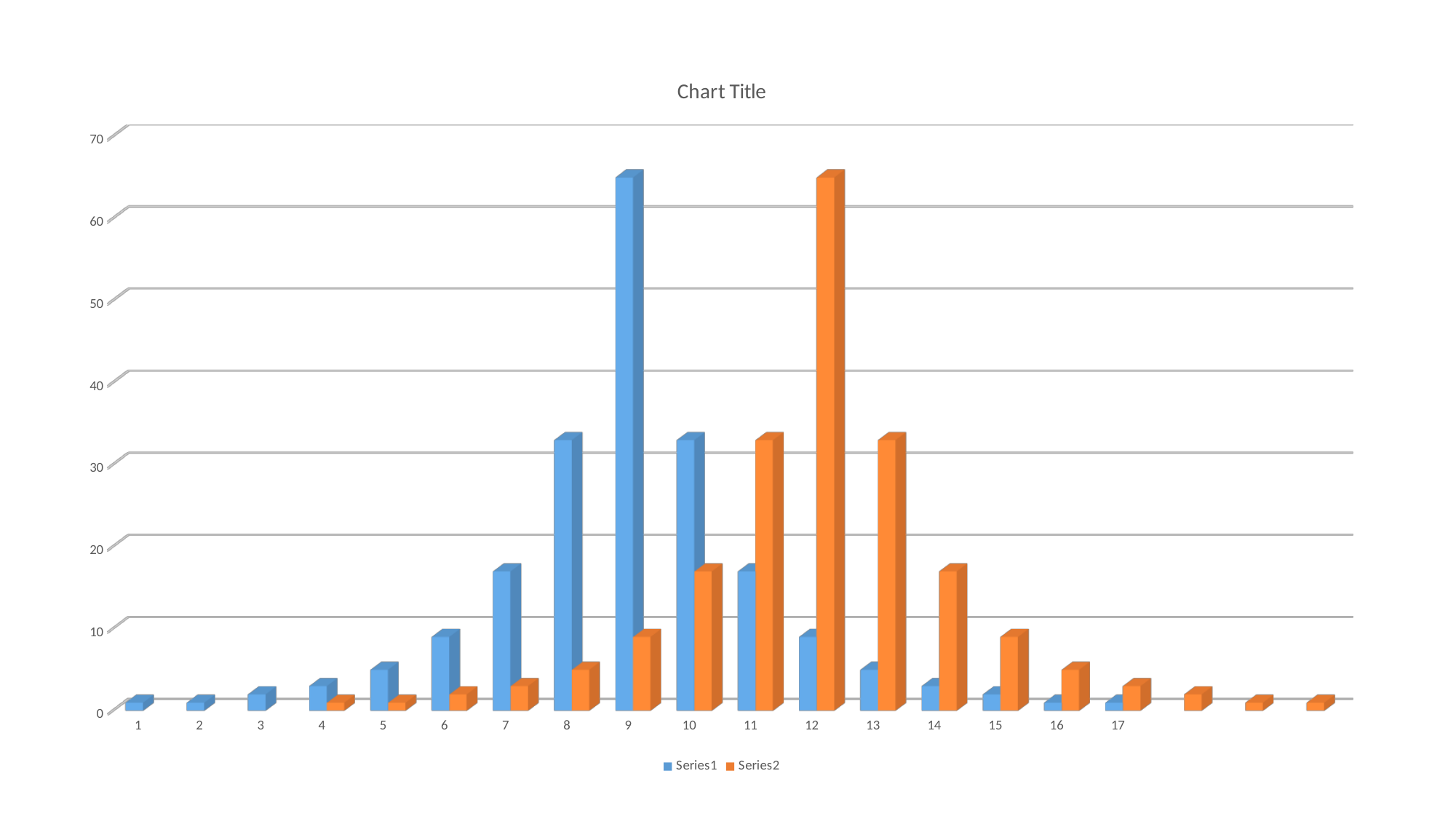
Is the value of Series1 at category 9 greater or less than 60? greater Do the Series1 values rise or fall from category 9 to category 17? fall Is the value of Series2 at category 13 greater or less than 30? greater At which category does Series2 reach its highest value? 12 What are the names of the series in the legend? Series1 and Series2 Is the value of Series1 at category 7 greater or less than 20? less At category 10, which series has the larger value, Series1 or Series2? Series1 At which category does Series1 reach its highest value? 9 At category 11, which series has the larger value, Series1 or Series2? Series2 What kind of chart is shown on the slide? bar chart What is the title of the chart? Chart Title How many series does the legend list? 2